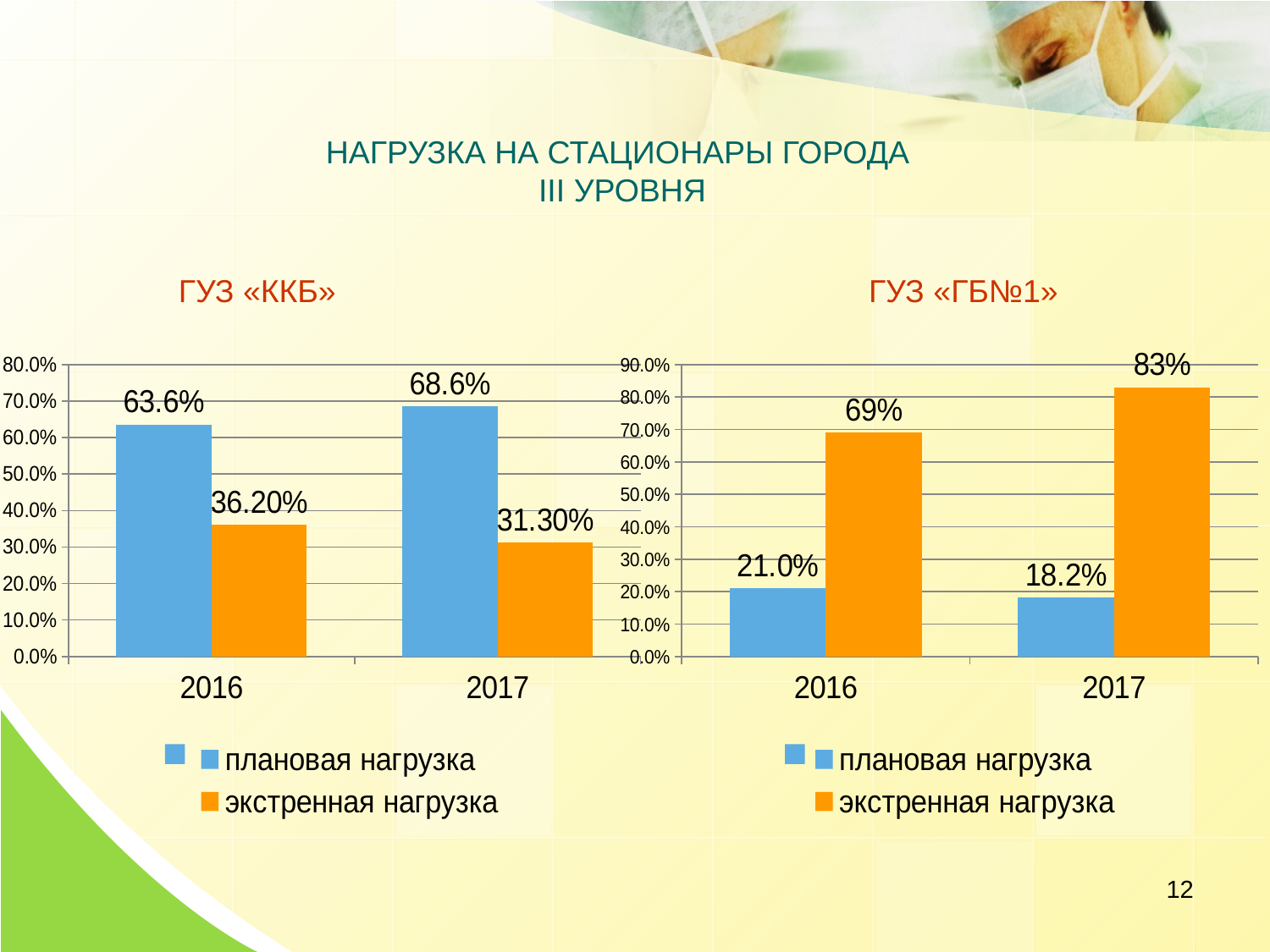
How many series does the legend of the ГУЗ «ГБ№1» chart list? 2 In the ГУЗ «ККБ» chart, by how many percentage points did плановая нагрузка change from 2016 to 2017? 5.0 percentage points In the ГУЗ «ККБ» chart, what is the value of плановая нагрузка for 2016? 63.6% In the ГУЗ «ККБ» chart, what is the value of экстренная нагрузка for 2017? 31.30% In the ГУЗ «ГБ№1» chart, does экстренная нагрузка rise or fall from 2016 to 2017? rise In the ГУЗ «ГБ№1» chart, what is the difference between экстренная нагрузка in 2017 and 2016? 14 percentage points What kind of chart is the ГУЗ «ККБ» chart? bar chart In the ГУЗ «ГБ№1» chart, what is the value of экстренная нагрузка for 2017? 83% In the ГУЗ «ГБ№1» chart, what is the value of плановая нагрузка for 2016? 21.0% In the ГУЗ «ГБ№1» chart, which year has the lower плановая нагрузка? 2017 In the ГУЗ «ККБ» chart, which year has the higher плановая нагрузка? 2017 In the ГУЗ «ККБ» chart, does экстренная нагрузка rise or fall from 2016 to 2017? fall